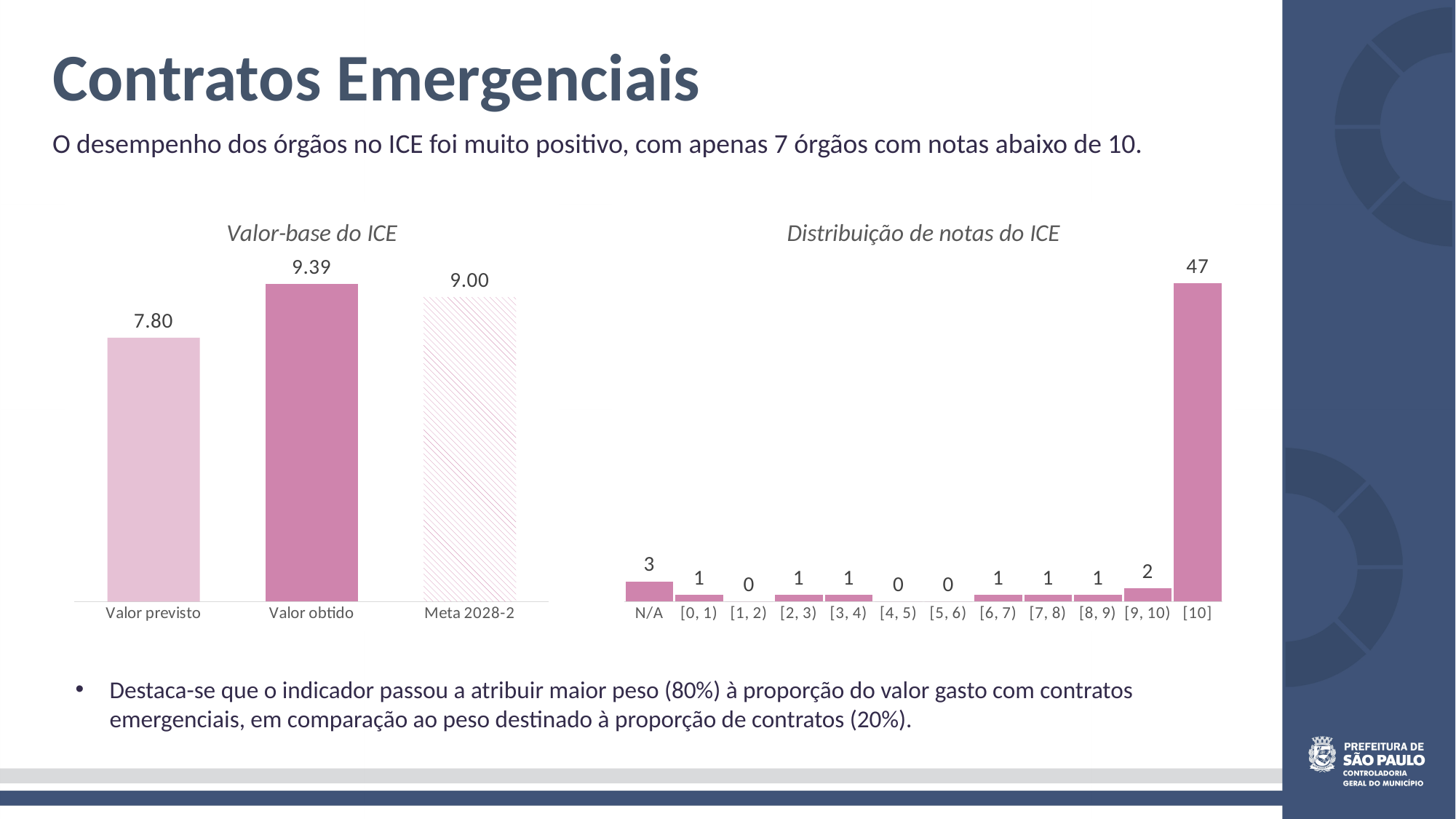
In the 'Valor-base do ICE' chart, what is the value for Valor previsto? 7.80 In the 'Distribuição de notas do ICE' chart, what is the value for N/A? 3 What kind of chart is 'Distribuição de notas do ICE'? Bar chart How many categories are shown on the x axis of the 'Distribuição de notas do ICE' chart? 12 In the 'Valor-base do ICE' chart, what is the value for Valor obtido? 9.39 In the 'Distribuição de notas do ICE' chart, what is the difference between the [10] category and N/A? 44 In the 'Valor-base do ICE' chart, what is the difference between Valor obtido and Valor previsto? 1.59 In the 'Valor-base do ICE' chart, which is larger: Valor obtido or Meta 2028-2? Valor obtido In the 'Valor-base do ICE' chart, which category has the highest value? Valor obtido In the 'Valor-base do ICE' chart, what is the value for Meta 2028-2? 9.00 In the 'Distribuição de notas do ICE' chart, what is the value for the [10] category? 47 In the 'Distribuição de notas do ICE' chart, what is the value for [9, 10)? 2